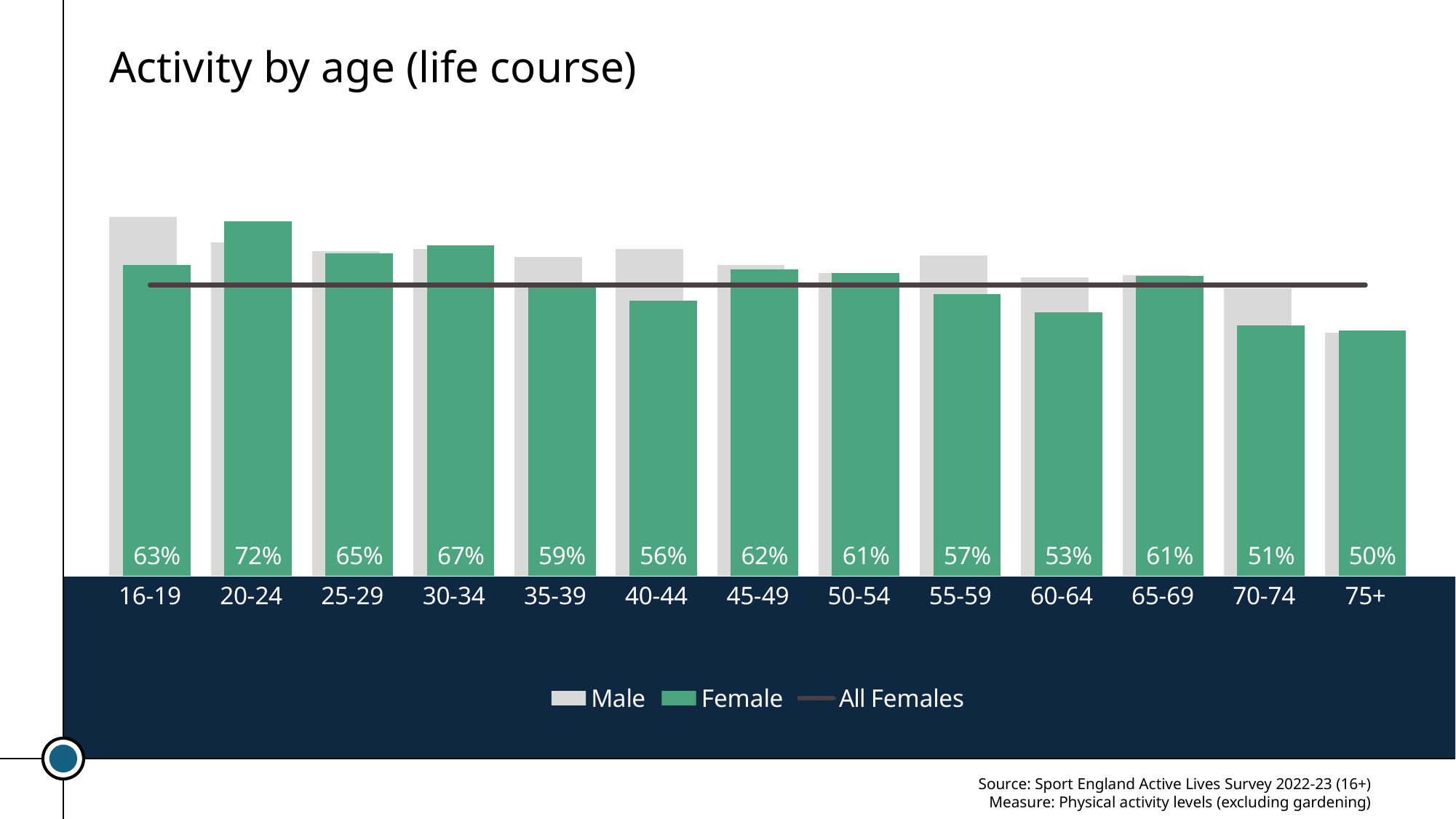
Do the Female values generally rise or fall from the 20-24 age group to the 75+ age group? fall Which age group has the highest Female value? 20-24 For the 16-19 age group, which is larger, the Male bar or the Female bar? Male What is the difference between the Female values for 20-24 and 75+? 22% Which age group has the lowest Female value? 75+ What is the Female value for the 75+ age group? 50% What is the Female value for the 20-24 age group? 72% How many series does the legend list? 3 How many age groups are shown on the x axis? 13 What is the difference between the Female values for 16-19 and 35-39? 4% What is the Female value for the 40-44 age group? 56% For the 20-24 age group, which is larger, the Male bar or the Female bar? Female